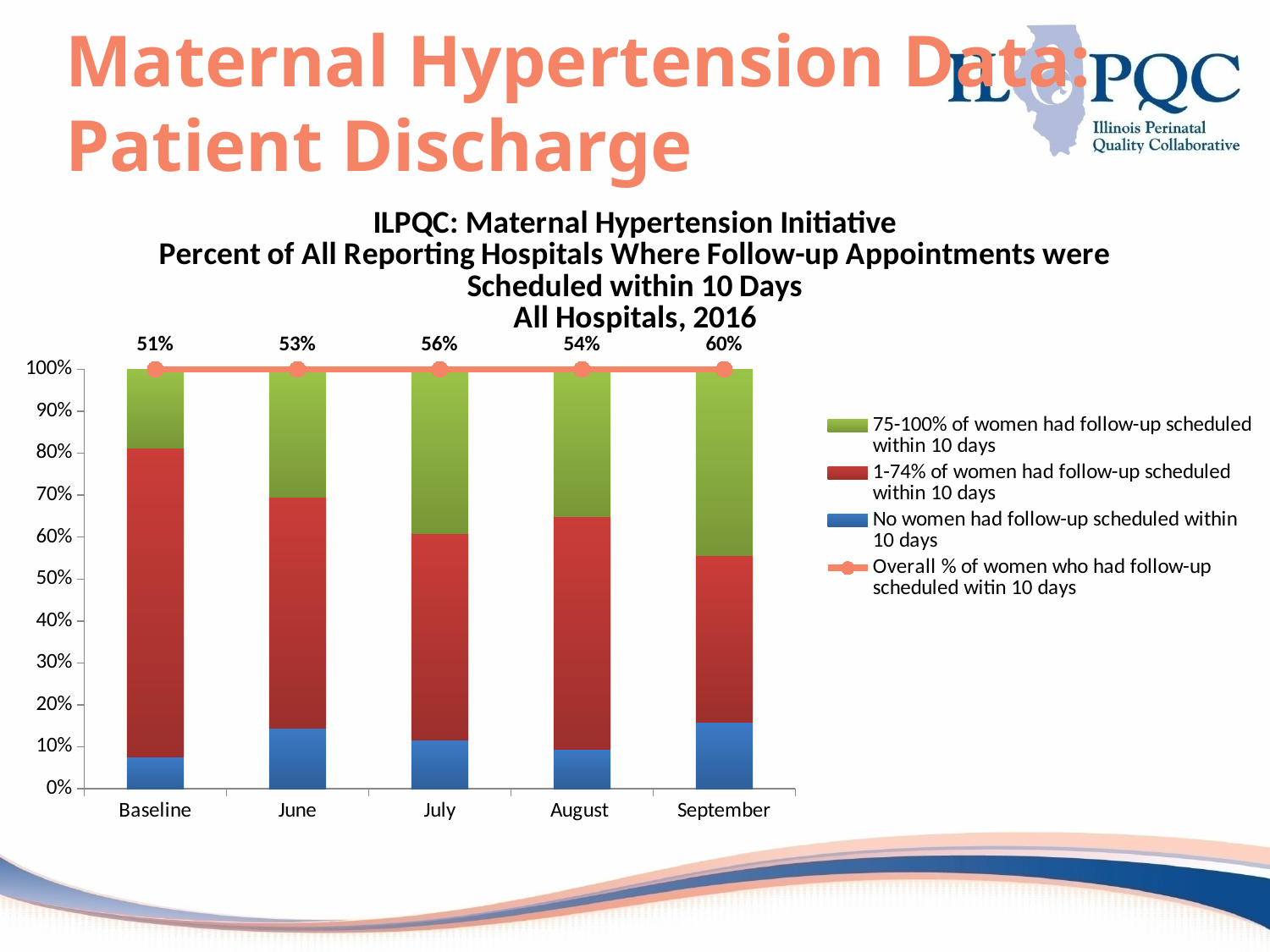
What is the overall % of women who had follow-up scheduled within 10 days in September? 60% How many series does the legend list? 4 Which is larger, the overall % for July or for August? July By how many percentage points does the overall % in September exceed the overall % at Baseline? 9 percentage points How many time periods are shown on the x axis? 5 Which period has the lowest overall % of women who had follow-up scheduled within 10 days? Baseline Which month has the highest overall % of women who had follow-up scheduled within 10 days? September What kind of chart is shown on the slide? Stacked bar chart with a line Is the share of hospitals where no women had follow-up scheduled within 10 days at Baseline greater or less than 10%? less Is the share of hospitals where no women had follow-up scheduled within 10 days in September greater or less than 10%? greater What is the overall % of women who had follow-up scheduled within 10 days in July? 56% What is the overall % of women who had follow-up scheduled within 10 days at Baseline? 51%